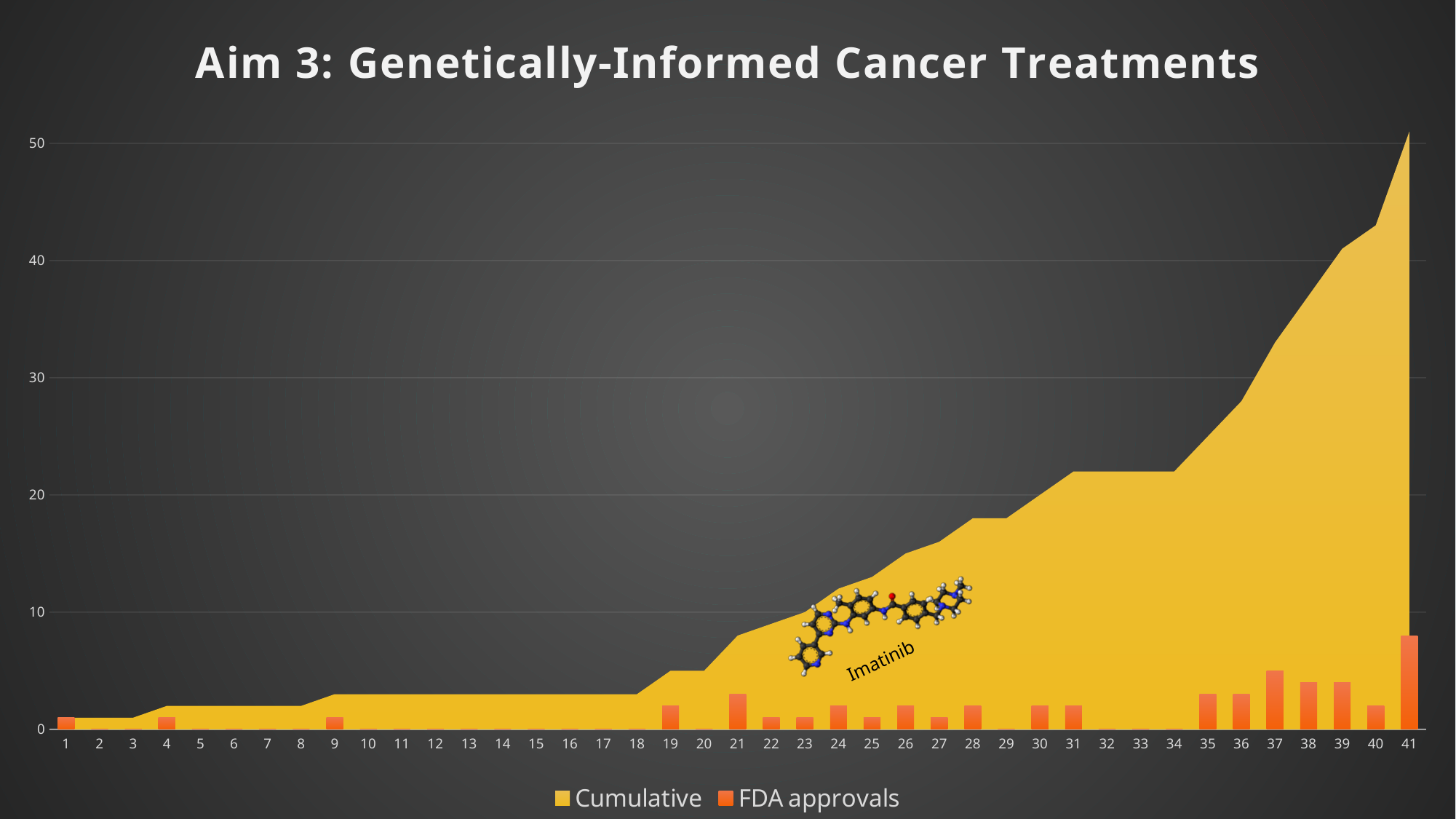
Is the FDA approvals value at category 41 greater or less than 10? less At which category does the FDA approvals series reach its highest value? 41 Is the Cumulative value at category 37 greater or less than 30? greater What are the two series named in the legend? Cumulative and FDA approvals What is the title of the slide containing the chart? Aim 3: Genetically-Informed Cancer Treatments At which category does the Cumulative series reach its highest value? 41 Does the Cumulative series generally rise or fall from category 1 to category 41? rise Is the Cumulative value at category 21 greater or less than 10? less Which is larger, the FDA approvals value at category 37 or at category 41? 41 How many categories are shown along the x axis? 41 How many series does the legend list? 2